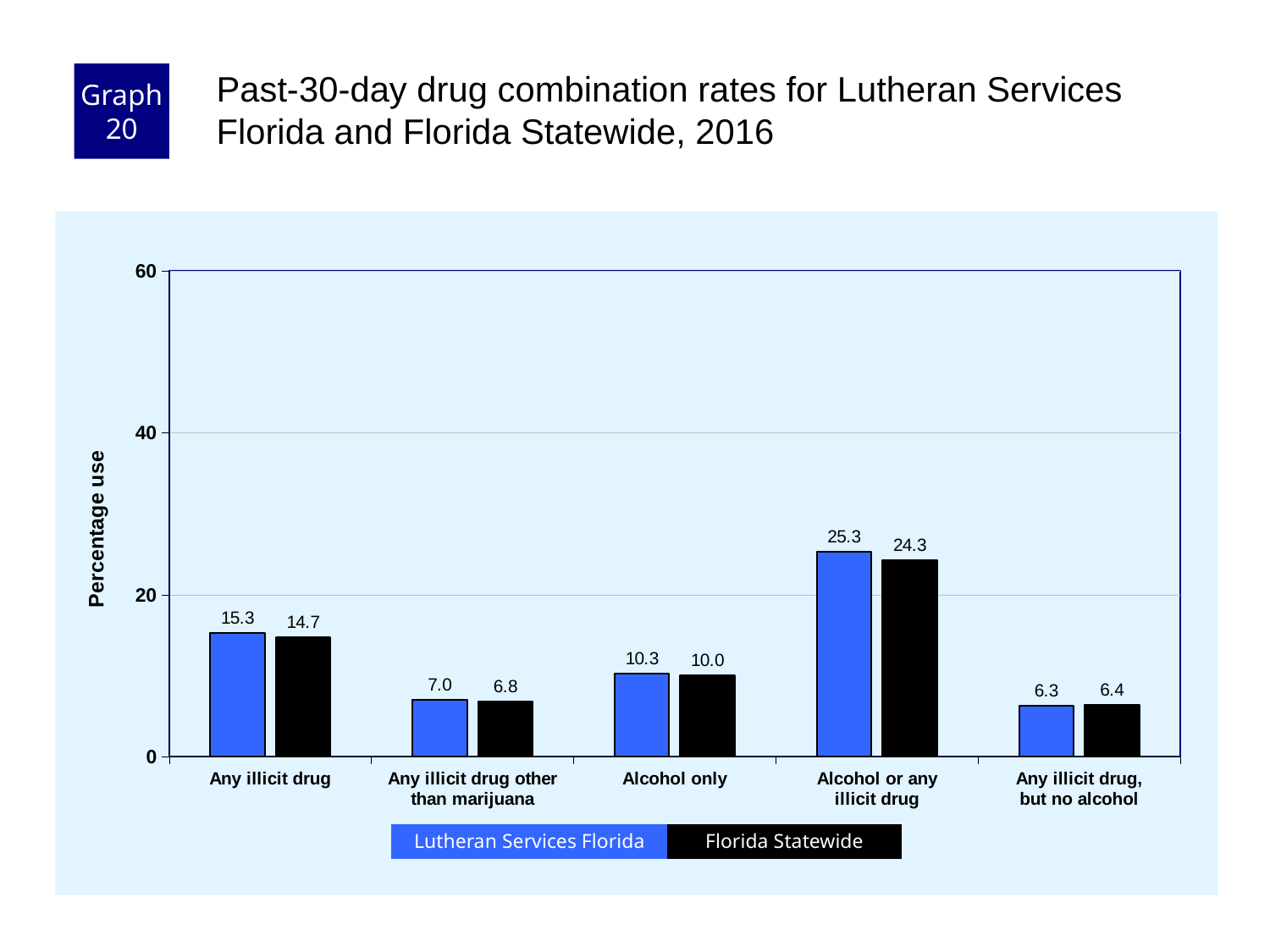
Is the Florida Statewide value for Alcohol or any illicit drug greater or less than 20? greater How many categories are shown on the x axis? 5 What is the Florida Statewide value for Any illicit drug, but no alcohol? 6.4 What is the Lutheran Services Florida value for Any illicit drug? 15.3 What is the difference between the Lutheran Services Florida values for Any illicit drug and Any illicit drug other than marijuana? 8.3 Which is larger: the Lutheran Services Florida value for Any illicit drug or the Lutheran Services Florida value for Alcohol only? Any illicit drug What is the Florida Statewide value for Alcohol only? 10.0 Which category has the lowest Florida Statewide value? Any illicit drug, but no alcohol Which category has the highest Lutheran Services Florida value? Alcohol or any illicit drug What is the difference between the Lutheran Services Florida and Florida Statewide values for Alcohol or any illicit drug? 1.0 What kind of chart is shown on the slide? bar chart How many series does the legend list? 2